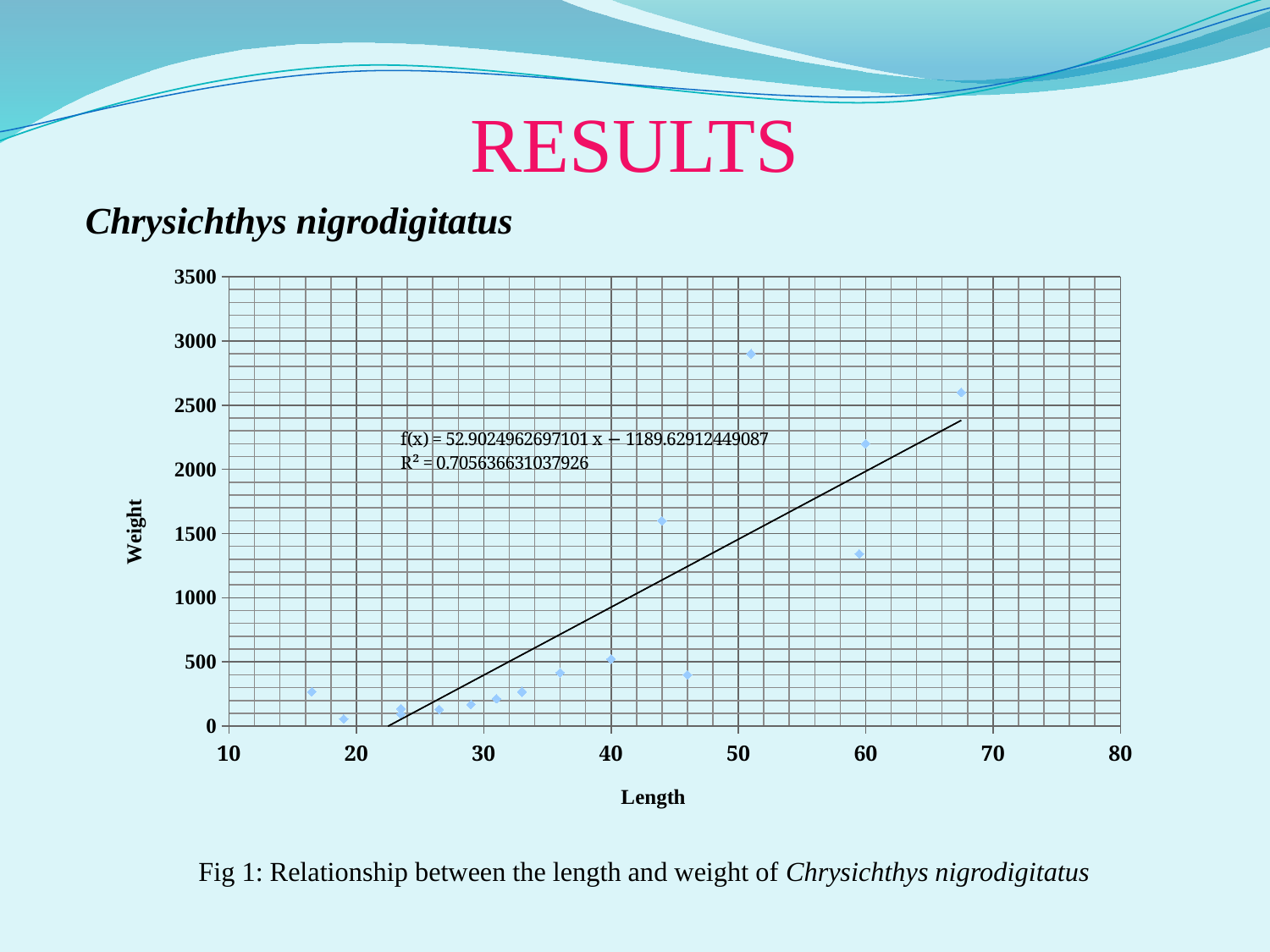
Is the lowest weight plotted on the chart greater or less than 500? less What kind of chart is shown on the slide? scatter plot Which has the greater weight: the point plotted at a length of about 51 or the point plotted at a length of about 60? the point at a length of about 51 What is the R² value printed on the chart? R² = 0.705636631037926 Is the weight of the point plotted at a length of about 19 greater or less than 500? less Does weight generally rise or fall as length increases along the x axis? rise Is the highest weight plotted on the chart greater or less than 2500? greater What is the trendline equation printed on the chart? f(x) = 52.9024962697101 x − 1189.62912449087 What is the maximum value shown on the Weight axis? 3500